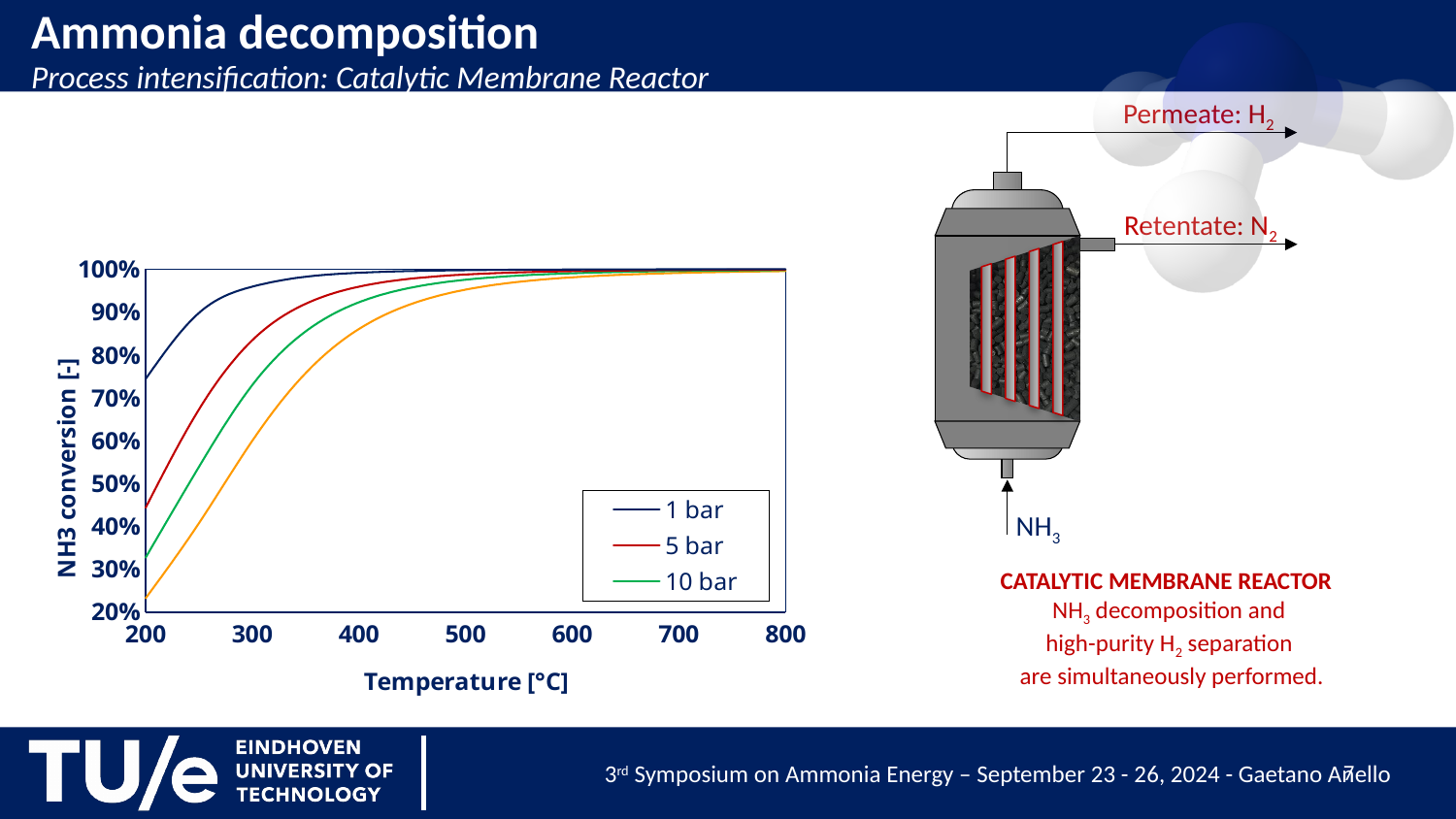
What is the label of the x axis of the chart? Temperature [°C] What kind of chart is shown on the slide? line chart How many temperature tick labels are shown on the x axis? 7 Is the NH3 conversion for the 10 bar series at 200 °C greater or less than 40%? less How many series does the chart legend list? 3 Does the NH3 conversion for the 1 bar series rise or fall as temperature increases? rise At 400 °C, which series has the higher NH3 conversion, 5 bar or 10 bar? 5 bar Is the NH3 conversion for the 5 bar series at 200 °C greater or less than 40%? greater Which of the legend series has the lowest NH3 conversion at 300 °C? 10 bar At 300 °C, which series has the higher NH3 conversion, 1 bar or 5 bar? 1 bar Is the NH3 conversion for the 1 bar series at 200 °C greater or less than 70%? greater Which series does the legend list first? 1 bar